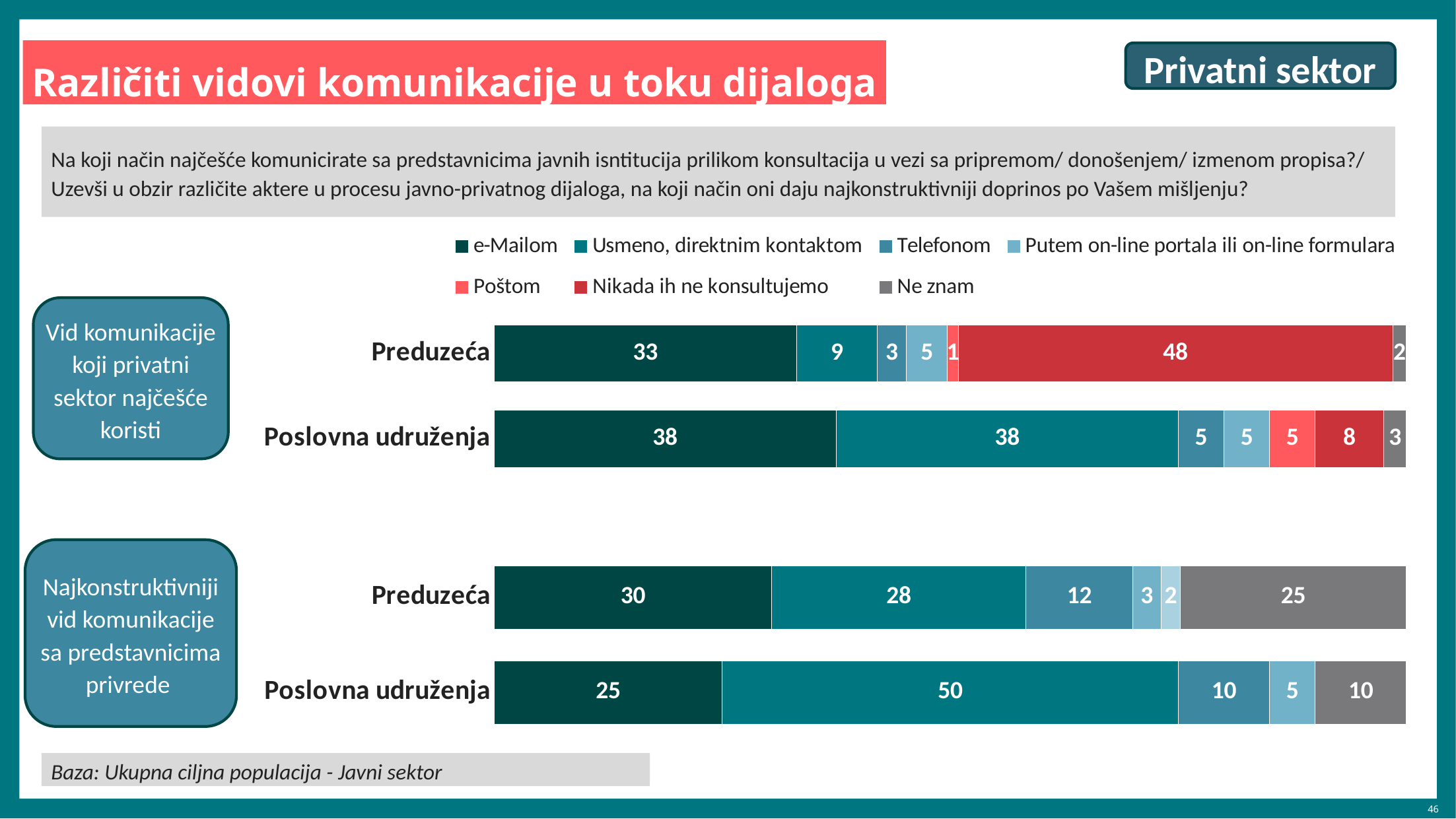
In the top chart, what is the total of the Preduzeća bar? 101 In the top chart, what is the difference between the 'Usmeno, direktnim kontaktom' values for Poslovna udruženja and Preduzeća? 29 How many series does the legend list? 7 In the top chart (Vid komunikacije koji privatni sektor najčešće koristi), what is the value for 'e-Mailom' for Poslovna udruženja? 38 In the top chart (Vid komunikacije koji privatni sektor najčešće koristi), what is the value for 'Nikada ih ne konsultujemo' for Preduzeća? 48 In the bottom chart, which segment is the smallest in the Poslovna udruženja bar? Putem on-line portala ili on-line formulara In the bottom chart, which is larger: the 'e-Mailom' value for Preduzeća or for Poslovna udruženja? Preduzeća In the bottom chart (Najkonstruktivniji vid komunikacije sa predstavnicima privrede), what is the value for 'Usmeno, direktnim kontaktom' for Poslovna udruženja? 50 In the bottom chart, what is the total of the Poslovna udruženja bar? 100 In the top chart, which segment is the largest in the Preduzeća bar? Nikada ih ne konsultujemo What kind of chart is used on this slide? Stacked bar chart In the bottom chart (Najkonstruktivniji vid komunikacije sa predstavnicima privrede), what is the value for 'Ne znam' for Preduzeća? 25